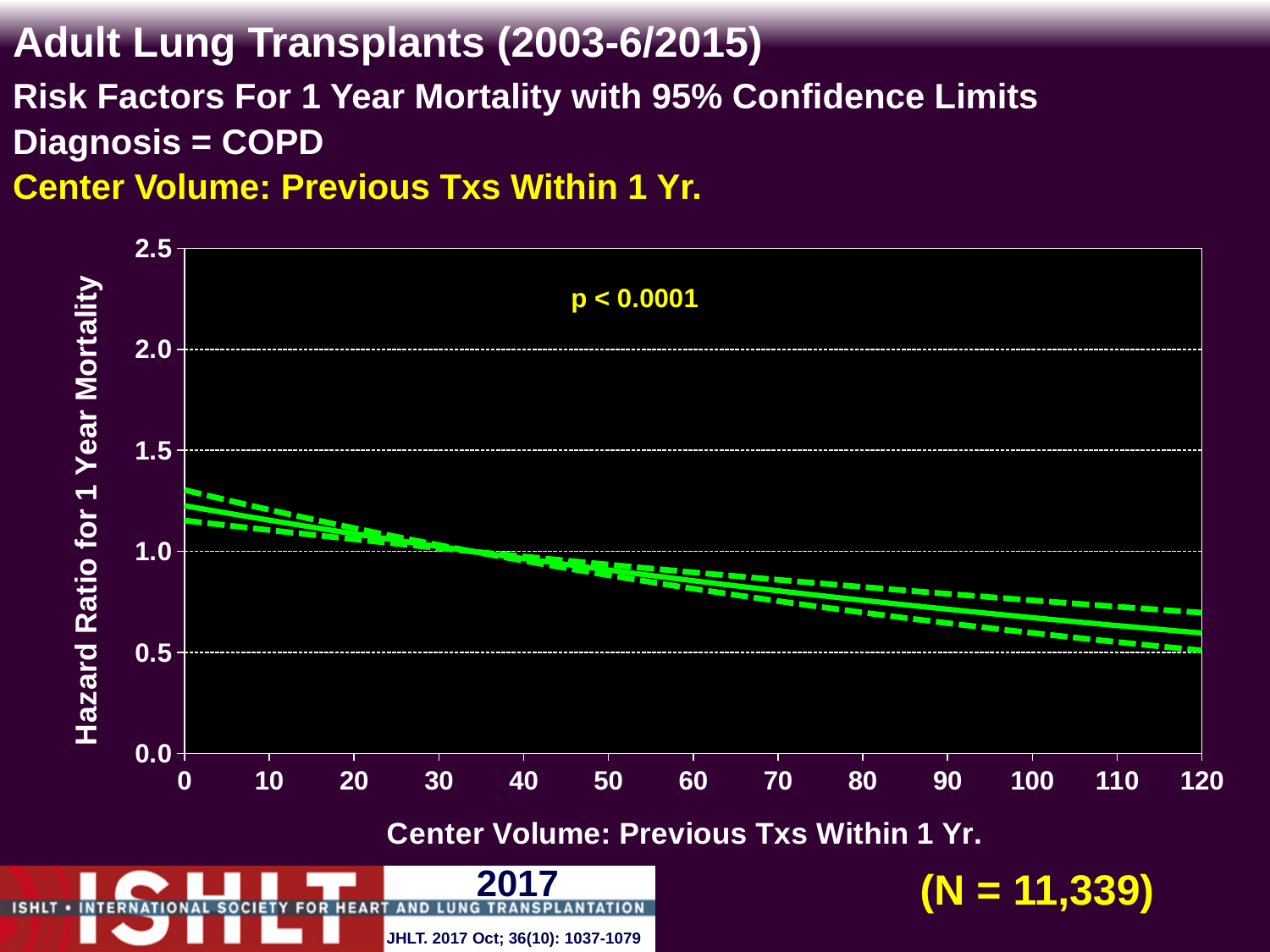
Does the hazard ratio rise or fall as center volume increases along the x axis? fall What kind of chart is shown on the slide? line chart What is the highest value shown on the y axis? 2.5 What p-value is printed on the chart? p < 0.0001 What is the label of the y axis? Hazard Ratio for 1 Year Mortality Is the hazard ratio at a center volume of 0 greater or less than 1.0? greater Which is larger, the hazard ratio at a center volume of 0 or at a center volume of 120? center volume of 0 Is the hazard ratio at a center volume of 0 greater or less than 1.5? less Is the hazard ratio at a center volume of 120 greater or less than 1.0? less How many lines are plotted on the chart (the estimate plus its confidence limits)? 3 What is the highest value shown on the x axis? 120